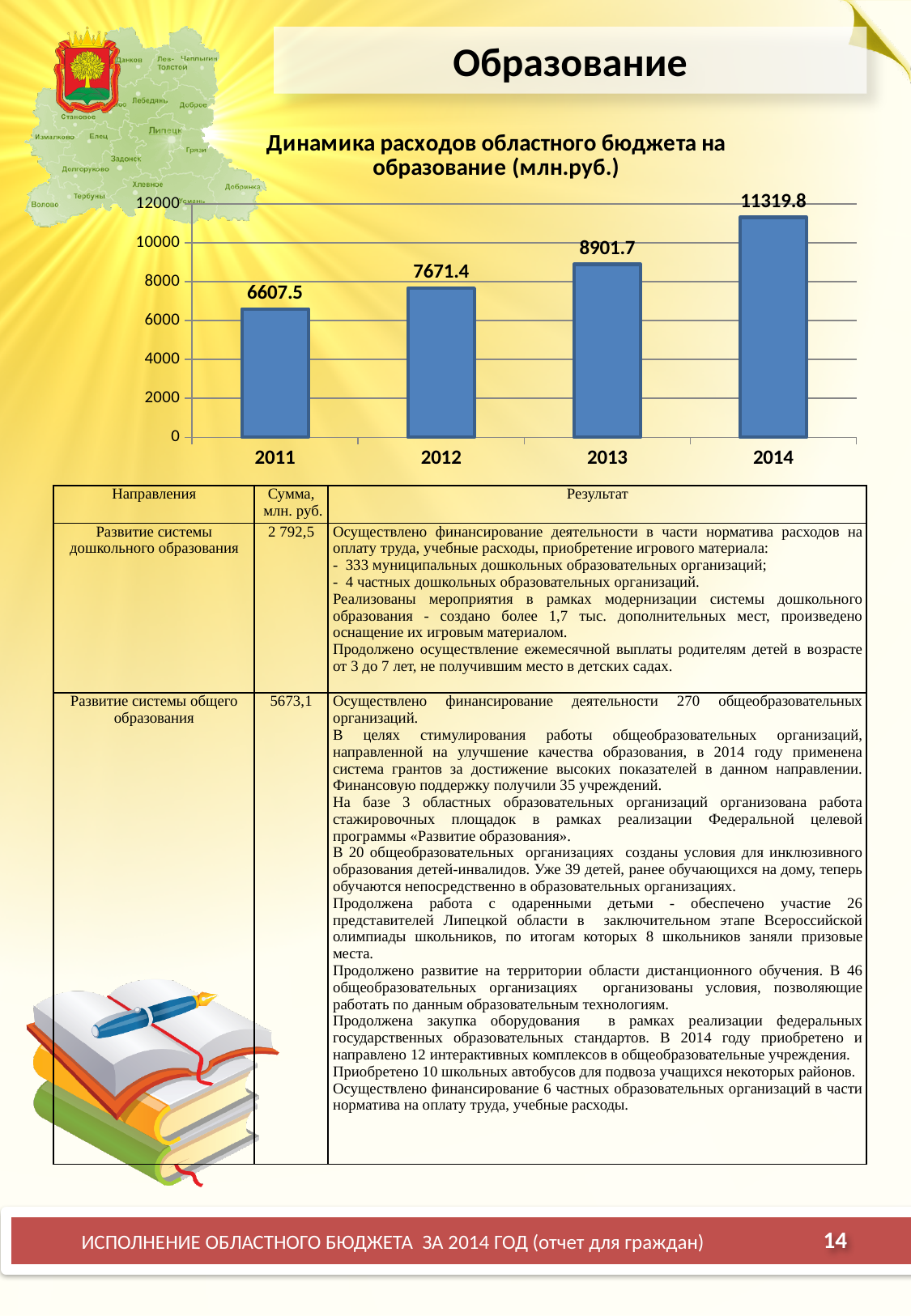
What is the value for 2014 in the chart? 11319.8 Which year has the lowest value in the chart? 2011 What is the value for 2011 in the chart? 6607.5 How many years are shown in the chart? 4 What is the value for 2013 in the chart? 8901.7 Which year has the highest value in the chart? 2014 Do the values rise or fall from 2011 to 2014? rise What is the difference between the values for 2014 and 2013? 2418.1 What is the difference between the values for 2012 and 2011? 1063.9 What type of chart is shown on the slide? bar chart Is the value for 2014 greater or less than 10000? greater Which is larger, the value for 2012 or the value for 2013? 2013